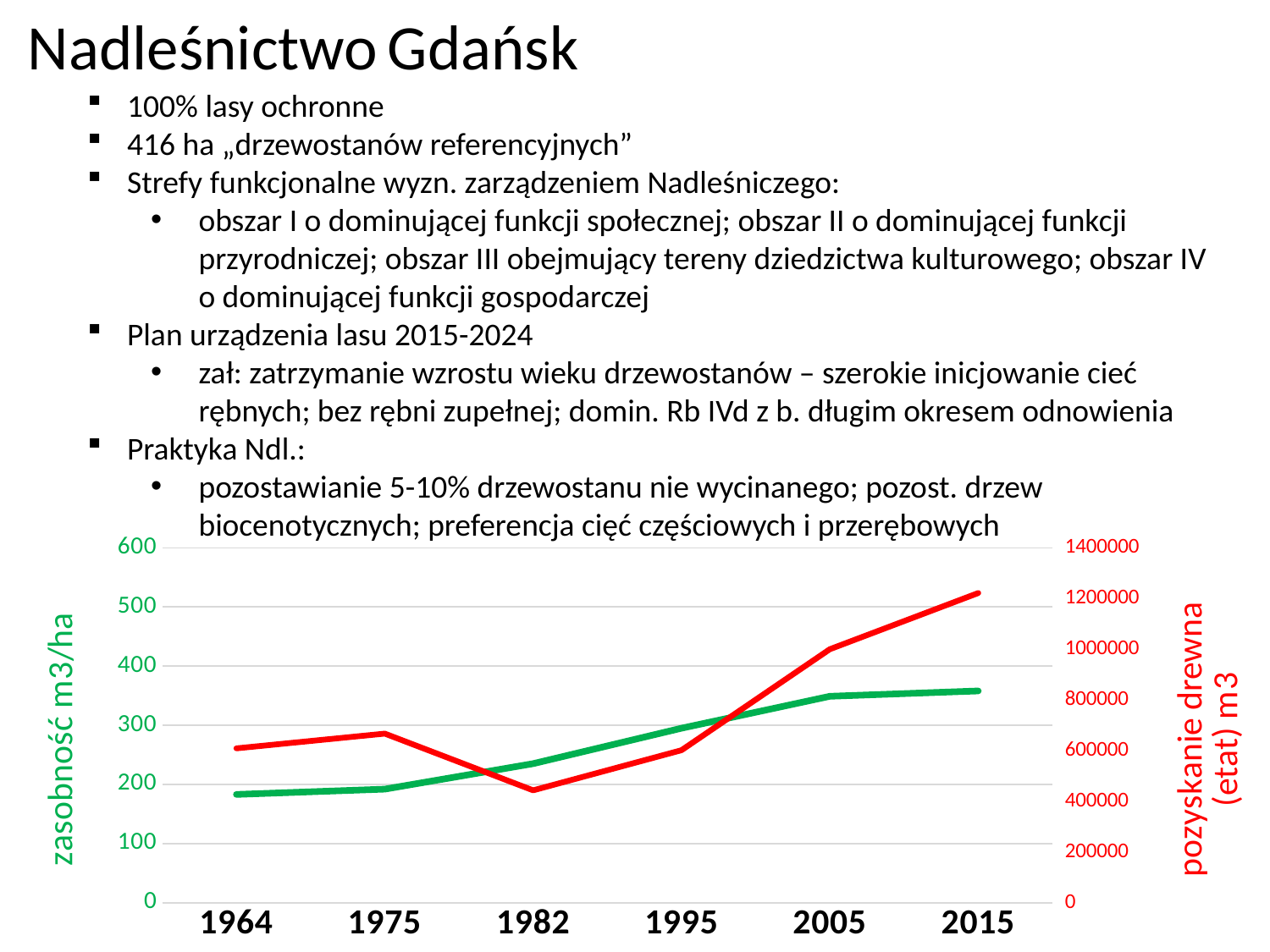
How many years are shown on the x axis of the chart? 6 In which year is the red line (pozyskanie drewna) at its lowest? 1982 Which year has the larger value on the red line (pozyskanie drewna): 1975 or 1982? 1975 Is the value of the green line (zasobność m3/ha) in 2015 greater or less than 300? greater Is the value of the red line (pozyskanie drewna) in 2005 greater or less than 800000? greater What is the title of the right-hand vertical axis of the chart? pozyskanie drewna (etat) m3 In which year is the red line (pozyskanie drewna) at its highest? 2015 Is the value of the green line (zasobność m3/ha) in 1964 greater or less than 200? less Which year is the first one shown on the x axis of the chart? 1964 In which year is the green line (zasobność m3/ha) at its highest? 2015 What kind of chart is shown at the bottom of the slide? line chart Does the green line (zasobność m3/ha) rise or fall from 1964 to 2015? rise